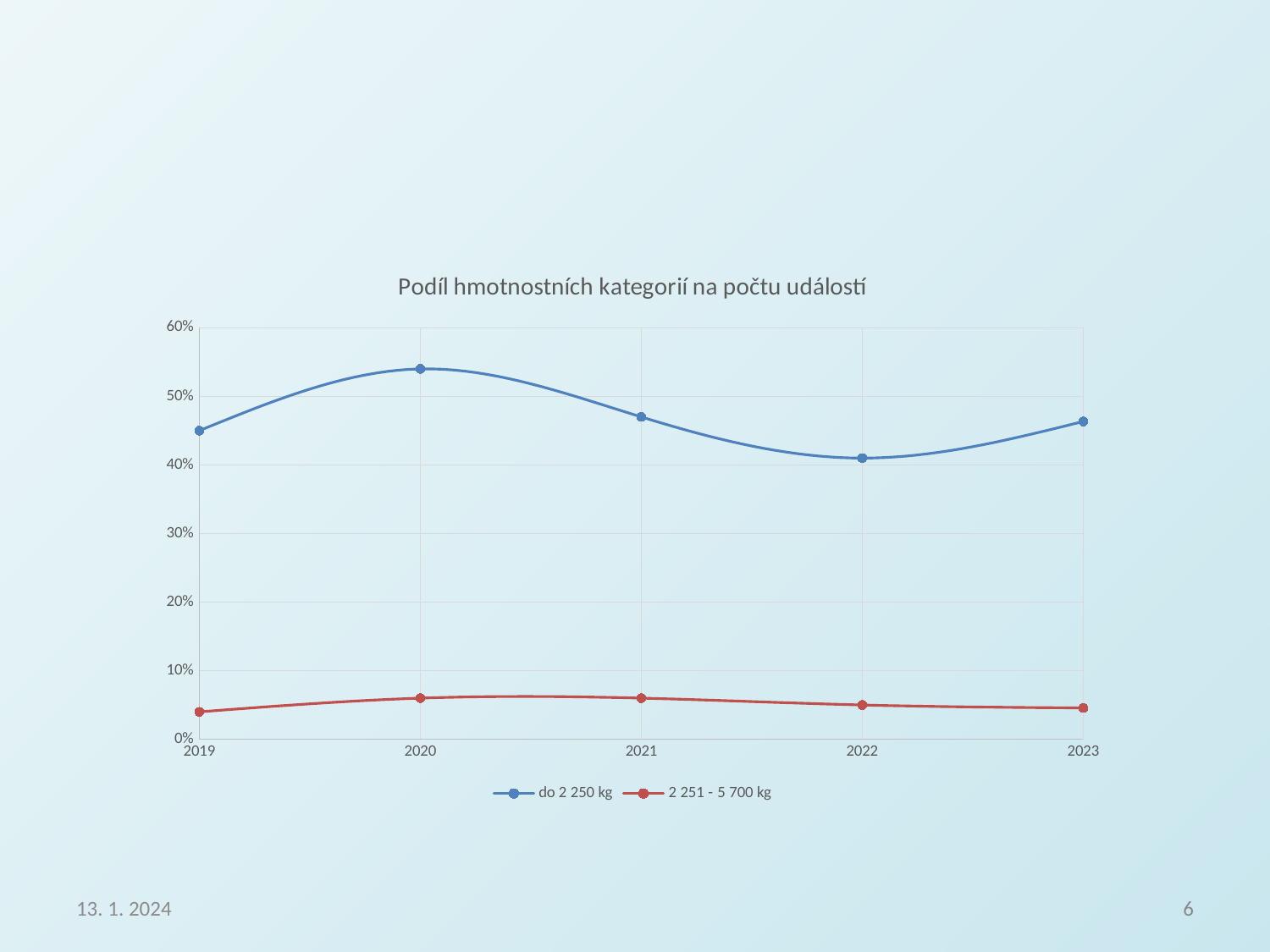
How many years are shown on the x axis? 5 In which year is the value for 'do 2 250 kg' highest? 2020 Is the value for '2 251 - 5 700 kg' in 2020 greater or less than 10%? less How many series does the legend list? 2 What kind of chart is shown on the slide? line chart Is the value for 'do 2 250 kg' in 2022 greater or less than 50%? less What is the title of the chart? Podíl hmotnostních kategorií na počtu událostí Which series has the higher value in 2020: 'do 2 250 kg' or '2 251 - 5 700 kg'? do 2 250 kg Is the value for 'do 2 250 kg' in 2020 greater or less than 50%? greater Does the value for 'do 2 250 kg' rise or fall from 2020 to 2022? fall In which year is the value for 'do 2 250 kg' lowest? 2022 Which is larger for 'do 2 250 kg': the value in 2021 or the value in 2022? 2021